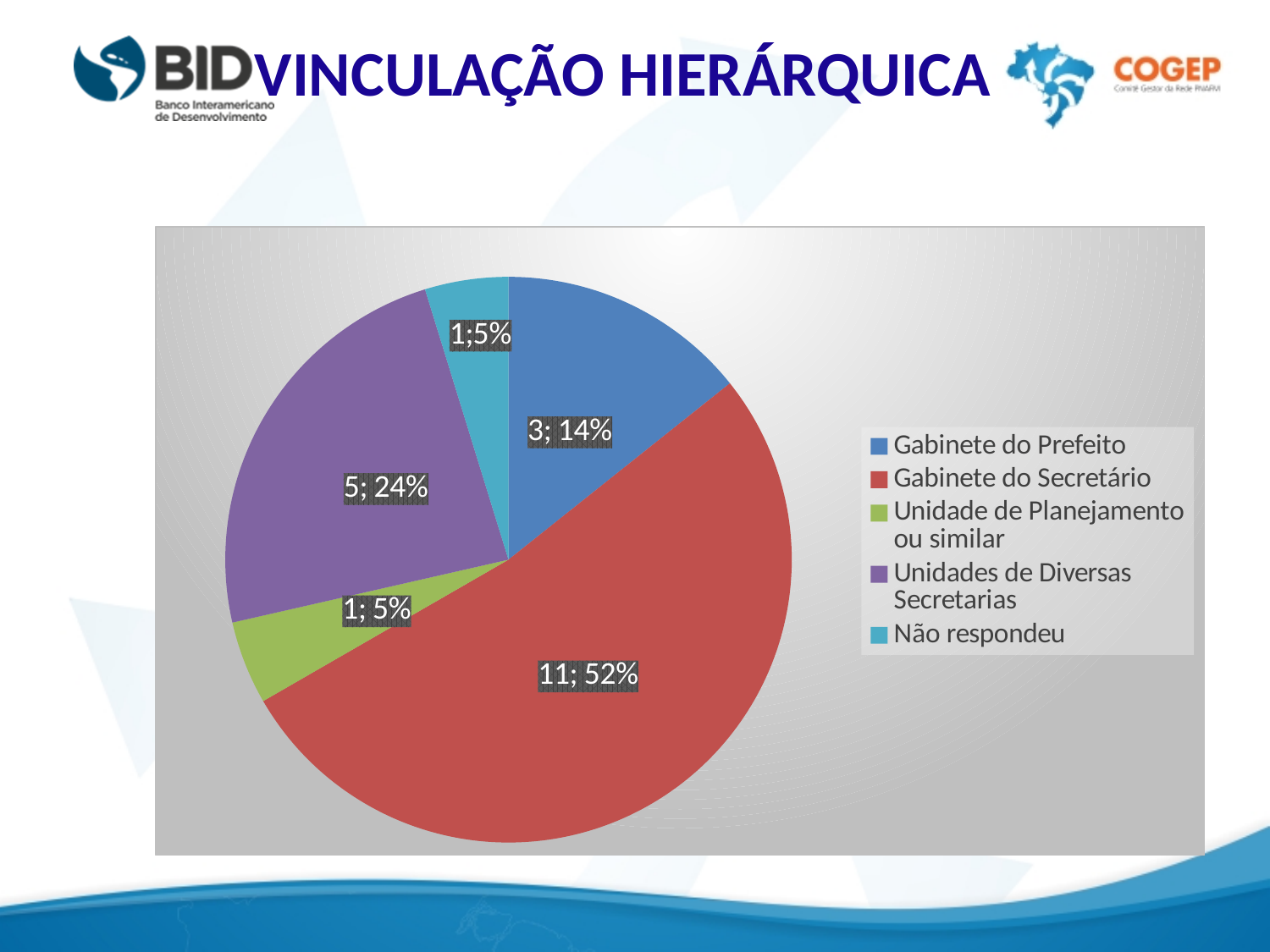
What percentage share does Gabinete do Secretário have? 52% What percentage share does Unidades de Diversas Secretarias have? 24% Which category has the largest slice? Gabinete do Secretário How many slices does the pie chart have? 5 What is the difference in count between Gabinete do Secretário and Unidades de Diversas Secretarias? 6 What percentage share does Não respondeu have? 5% What colour is the slice for Gabinete do Secretário? red Which is larger, Gabinete do Prefeito or Unidades de Diversas Secretarias? Unidades de Diversas Secretarias What is the count shown for Gabinete do Prefeito? 3 What is the title of the slide? VINCULAÇÃO HIERÁRQUICA What kind of chart is shown on the slide? pie chart What is the count shown for Gabinete do Secretário? 11